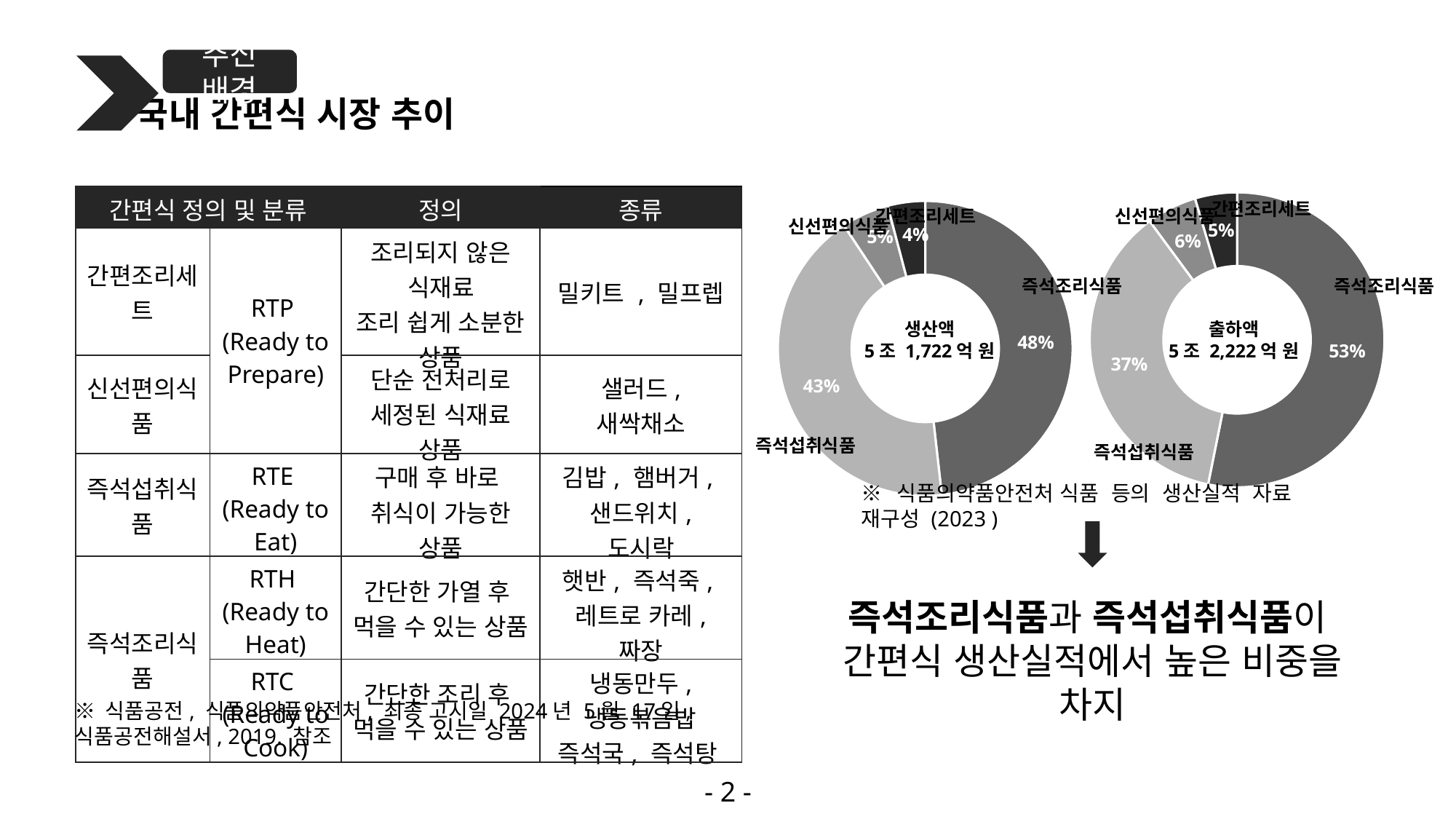
What type of chart is used to show 생산액 and 출하액 on the slide? Donut (pie) chart In the 생산액 chart, what share does 간편조리세트 hold? 4% In the 출하액 chart, what share does 즉석조리식품 hold? 53% What total value is printed in the centre of the 출하액 chart? 5조 2,222억 원 In the 생산액 chart, which category has the smallest share? 간편조리세트 In the 생산액 chart, what share does 즉석조리식품 hold? 48% How many categories are shown in the 생산액 donut chart? 4 In the 출하액 chart, what share does 신선편의식품 hold? 6% In the 출하액 chart, which category has the largest share? 즉석조리식품 Which is larger: the share of 즉석섭취식품 in the 생산액 chart or in the 출하액 chart? 생산액 chart (43%) In the 출하액 chart, what is the difference between the shares of 즉석조리식품 and 즉석섭취식품? 16% In the 생산액 chart, what share does 즉석섭취식품 hold? 43%